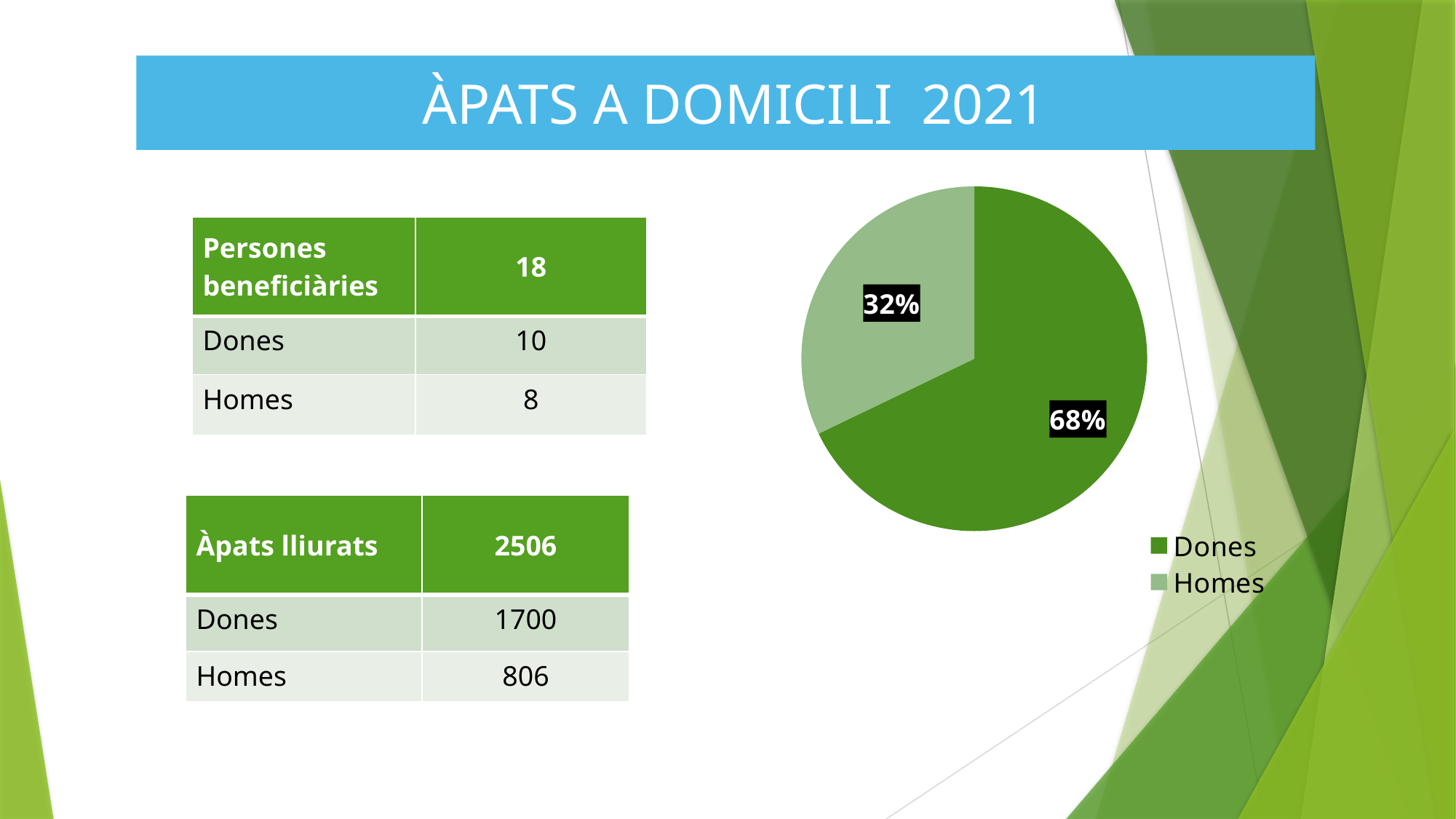
What share of the pie chart does Homes represent? 32% How many entries does the pie chart legend list? 2 What are the two legend entries of the pie chart? Dones and Homes In the pie chart, which is larger, Dones or Homes? Dones What is the difference in percentage points between the Dones and Homes slices of the pie chart? 36 What kind of chart is shown on the slide? pie chart Is the share for Homes in the pie chart greater or less than 50%? less Which slice of the pie chart is drawn in the darker green? Dones What share of the pie chart does Dones represent? 68% Which slice of the pie chart is the largest? Dones How many slices does the pie chart have? 2 Which slice of the pie chart is the smallest? Homes